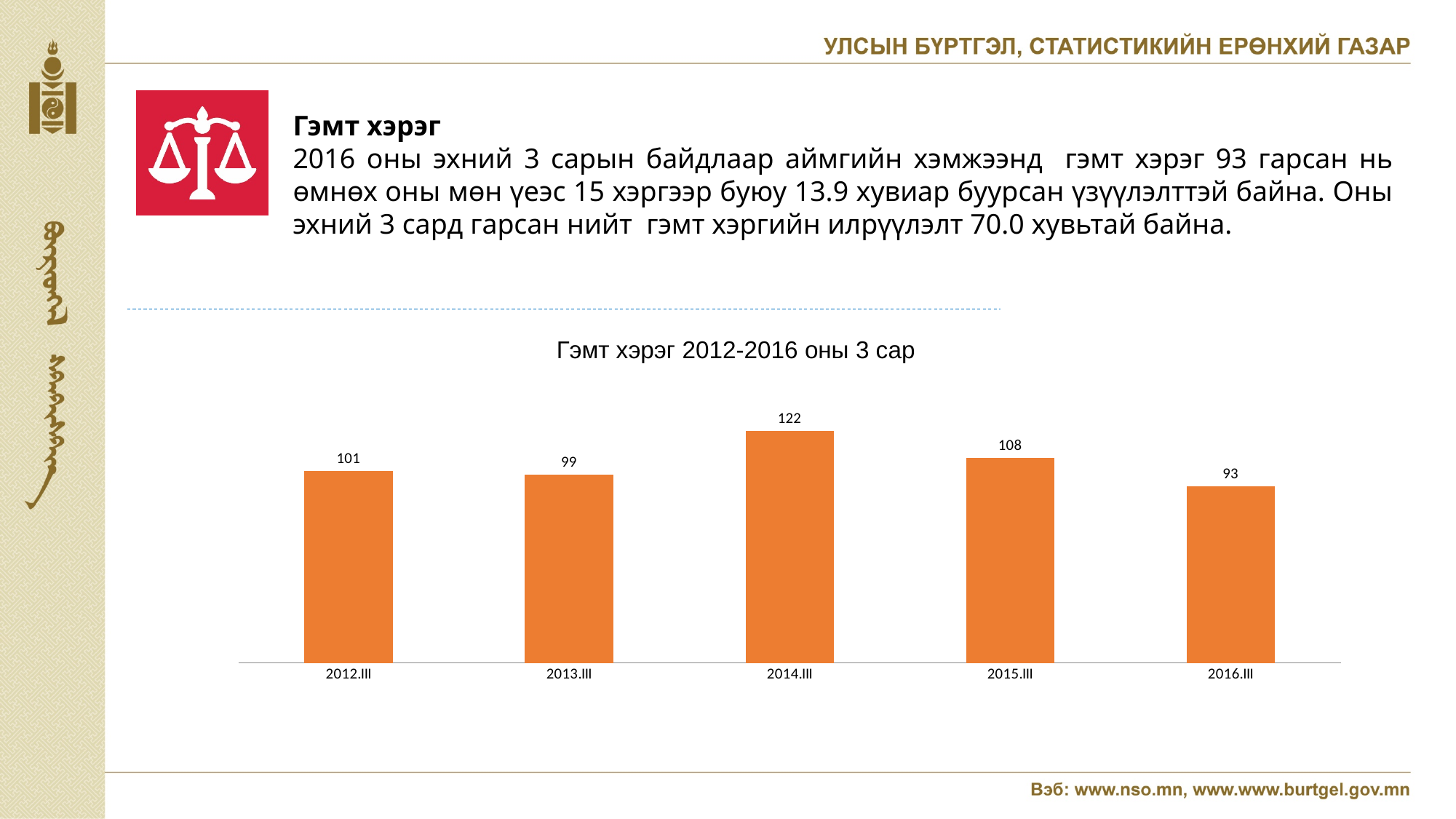
Which category has the lowest value? 2016.III What is the difference between the values for 2014.III and 2015.III? 14 Do the values rise or fall from 2014.III to 2016.III? fall What is the title of the chart? Гэмт хэрэг 2012-2016 оны 3 сар What is the value for 2014.III? 122 What is the difference between the values for 2015.III and 2016.III? 15 What is the value for 2012.III? 101 Which is larger, the value for 2012.III or the value for 2013.III? 2012.III Which category has the highest value? 2014.III What is the value for 2016.III? 93 What kind of chart is shown on the slide? bar chart How many categories are shown on the x axis? 5